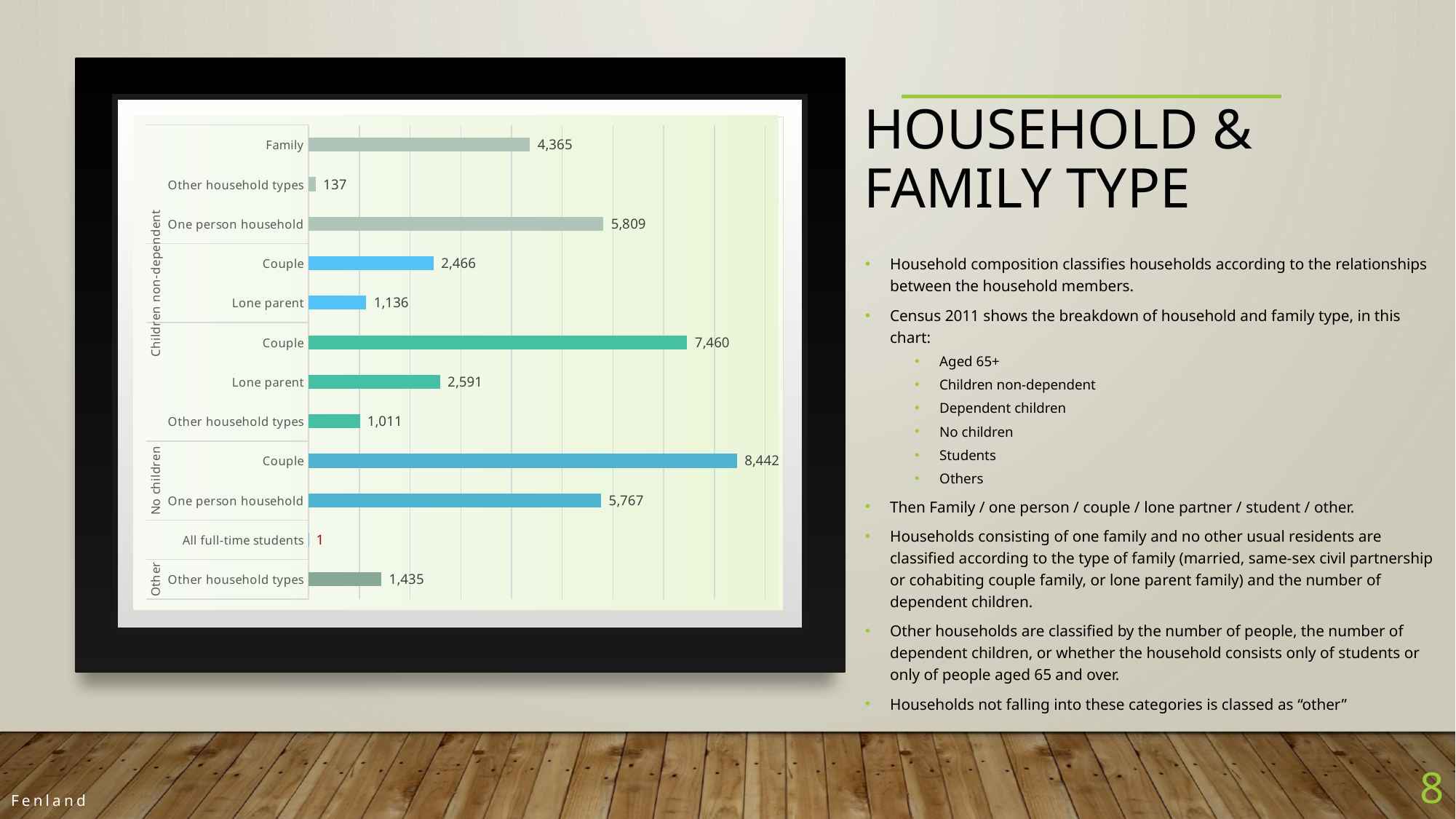
How many bars are plotted in the chart? 12 What is the value of the topmost Other household types bar, just below Family? 137 What is the value for Other household types in the Other group (bottom bar)? 1,435 Which category has the lowest value in the chart? All full-time students What is the value for Family? 4,365 What type of chart is shown on the slide? Bar chart Which is larger: Family or the Other household types bar at the bottom of the chart? Family What is the value for All full-time students? 1 What is the value for One person household in the No children group? 5,767 What is the difference between Family and the Other household types bar directly below it? 4,228 Which category has the highest value in the chart? Couple (No children), 8,442 What is the difference between Couple and One person household in the No children group? 2,675